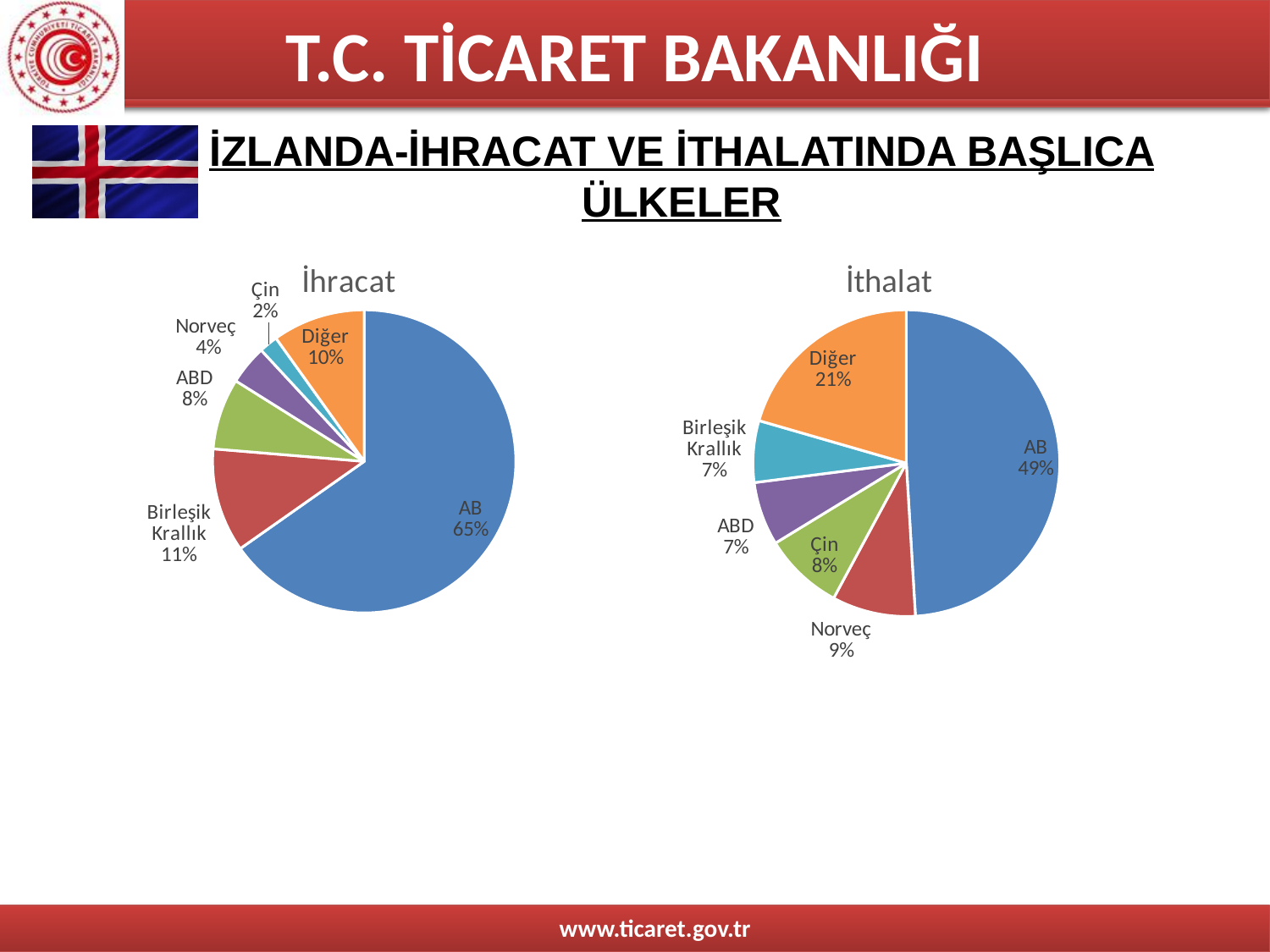
What type of chart is the İthalat chart? Pie chart What is the title of the pie chart on the right? İthalat In the İthalat pie chart, what share does Birleşik Krallık have? 7% In the İhracat pie chart, what share does AB have? 65% How many slices does the İhracat pie chart have? 6 In the İthalat pie chart, what share does Diğer have? 21% In the İhracat pie chart, what is the difference between the shares of Birleşik Krallık and ABD? 3% In the İhracat pie chart, which category has the smallest share? Çin In the İthalat pie chart, which is larger, the share of Norveç or the share of Çin? Norveç In the İthalat pie chart, which category has the largest share? AB What is the difference between the AB share in the İhracat chart and the AB share in the İthalat chart? 16% In the İhracat pie chart, what share does Norveç have? 4%